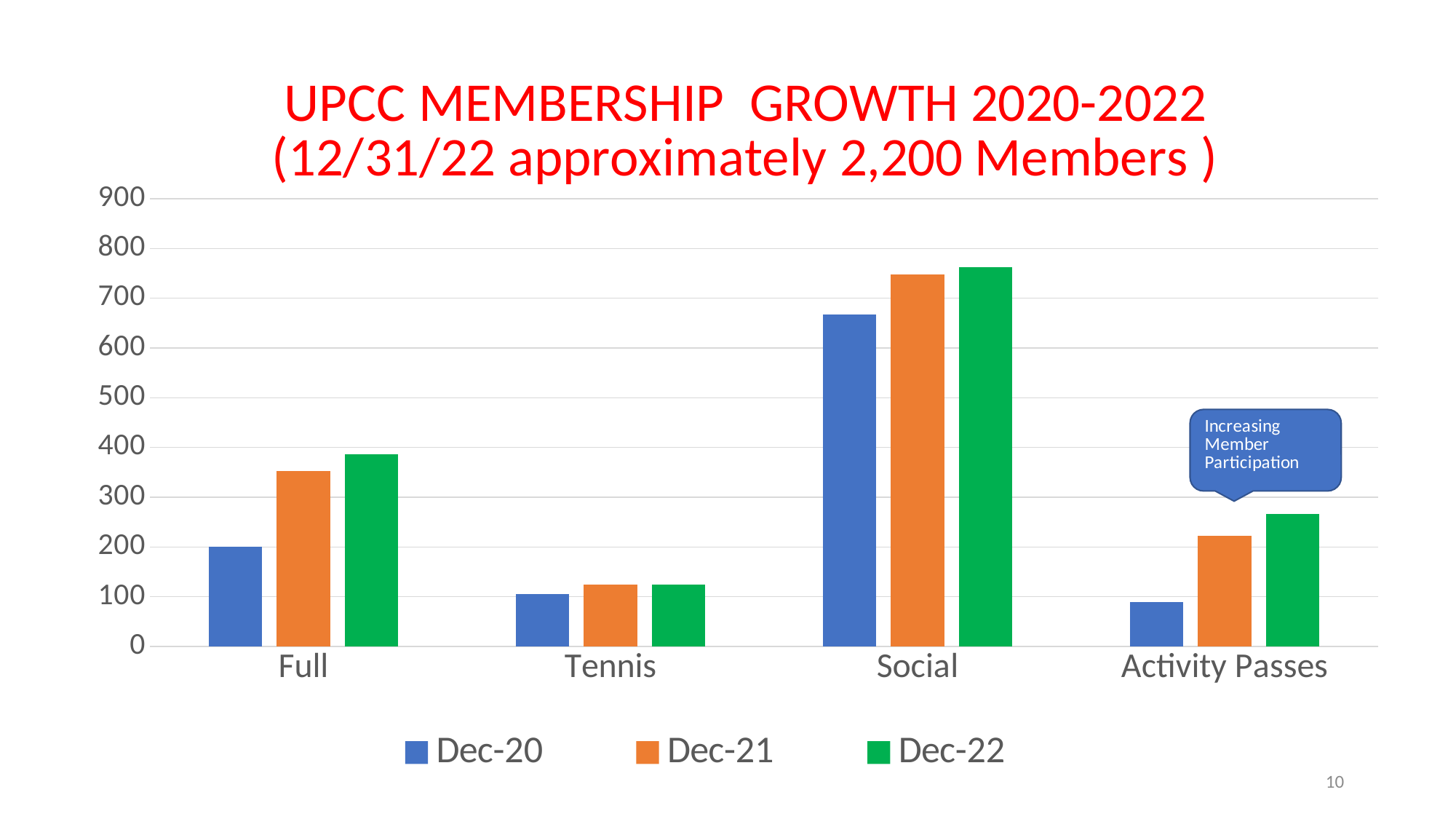
Is the Dec-21 value for Social greater or less than 700? greater How many membership categories are shown on the x axis? 4 Which is larger, the Dec-22 value for Social or the Dec-22 value for Full? Social Is the Dec-20 value for Social greater or less than 600? greater How many series does the legend list? 3 Which colour represents the Dec-22 series in the legend? Green What kind of chart is shown on the slide? Bar chart Which category has the lowest Dec-22 value? Tennis Do the values for Full rise or fall from Dec-20 to Dec-22? rise Which membership category has the highest bars overall? Social Is the Dec-22 value for Activity Passes greater or less than 300? less